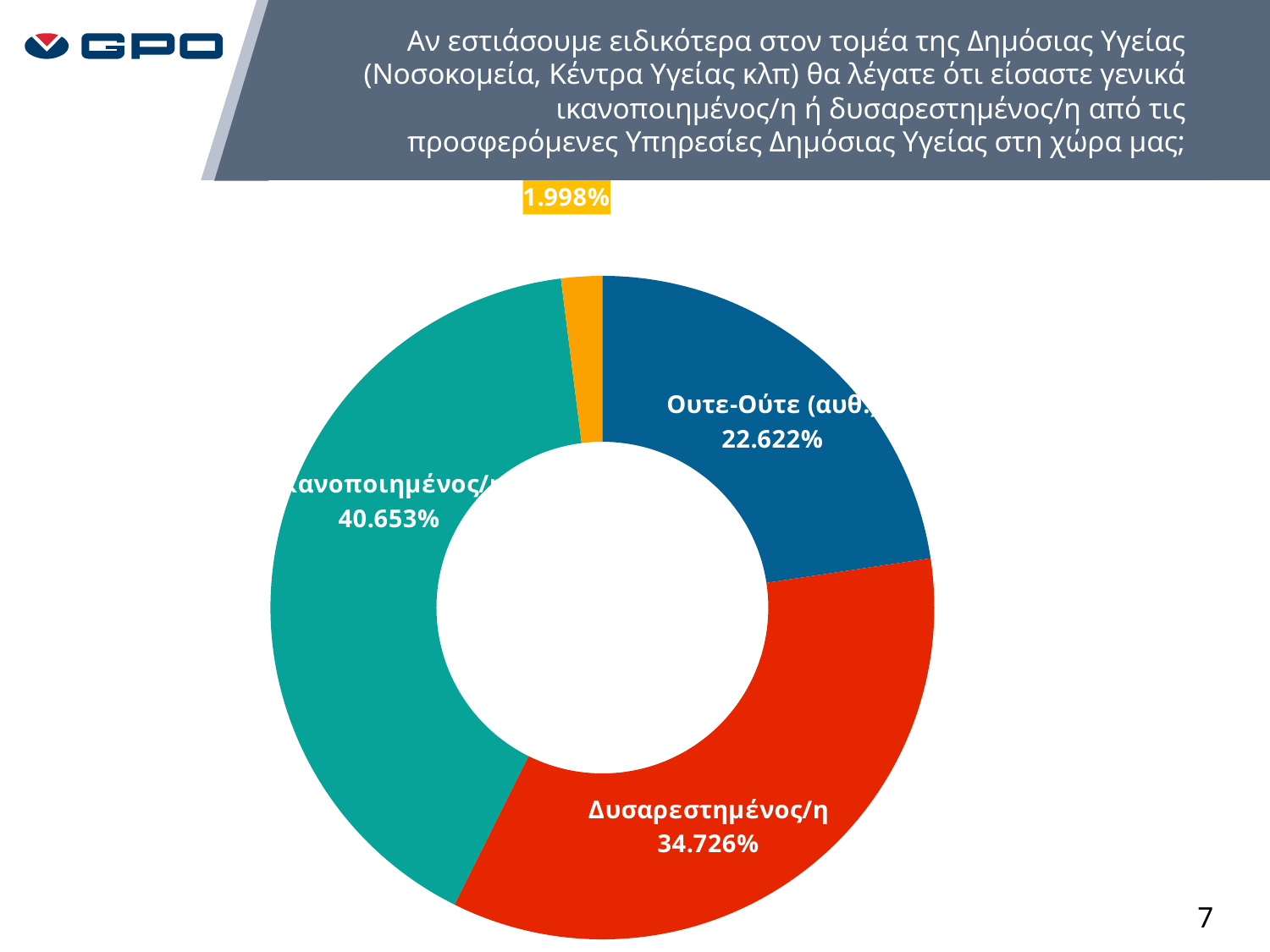
How many slices does the chart have? 4 Which category has the largest share of the chart? Ικανοποιημένος/η How many percentage points larger is Ικανοποιημένος/η than Δυσαρεστημένος/η? 5.927 percentage points What colour is the Δυσαρεστημένος/η slice? red What percentage is shown for Δυσαρεστημένος/η? 34.726% What is the difference between Δυσαρεστημένος/η and Ούτε-Ούτε (αυθ.)? 12.104 percentage points What kind of chart is shown on the slide? doughnut (pie) chart What percentage is shown for the small orange slice? 1.998% What percentage is shown for Ικανοποιημένος/η? 40.653% Which is larger, Δυσαρεστημένος/η or Ούτε-Ούτε (αυθ.)? Δυσαρεστημένος/η What is the value of the smallest slice in the chart? 1.998% What percentage is shown for Ούτε-Ούτε (αυθ.)? 22.622%